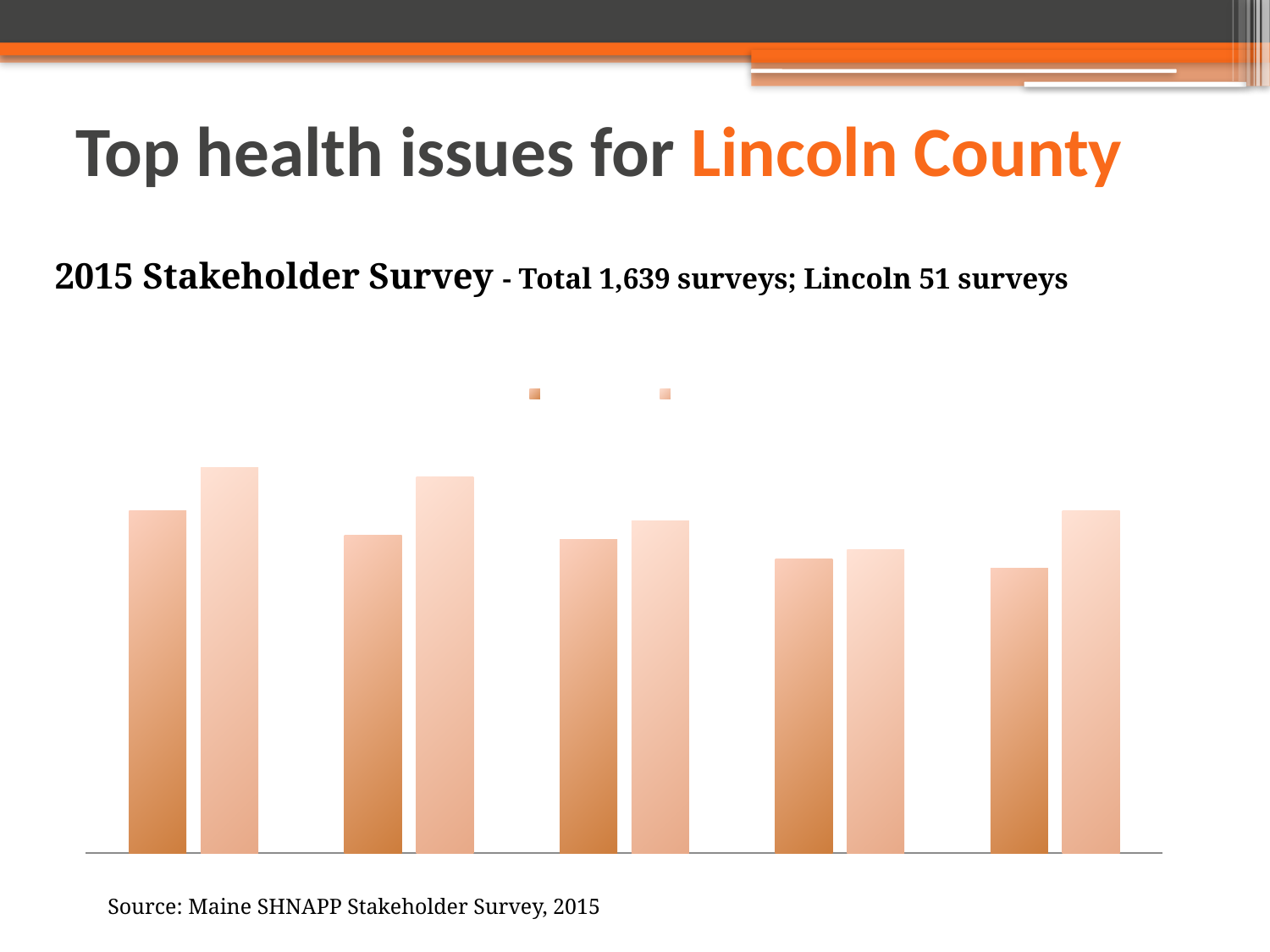
According to the slide subtitle, how many surveys were collected for Lincoln? 51 surveys Do the darker orange bars rise or fall moving from the first group to the fifth group along the x axis? Fall How many bars are plotted in total in the chart? 10 In the fifth group from the left, is the darker orange bar or the lighter orange bar taller? The lighter orange bar Is the darker orange bar in the first group taller or shorter than the darker orange bar in the fourth group? Taller How many series does the chart's legend indicate? 2 In the first group from the left, is the darker orange bar or the lighter orange bar taller? The lighter orange bar What kind of chart is shown on the slide? Bar chart Which group of bars, counting from the left, contains the tallest bar in the chart? The first (leftmost) group Which group of bars, counting from the left, contains the shortest bar in the chart? The fifth (rightmost) group What is the source cited below the chart? Maine SHNAPP Stakeholder Survey, 2015 How many groups of bars (categories) are plotted in the chart? 5